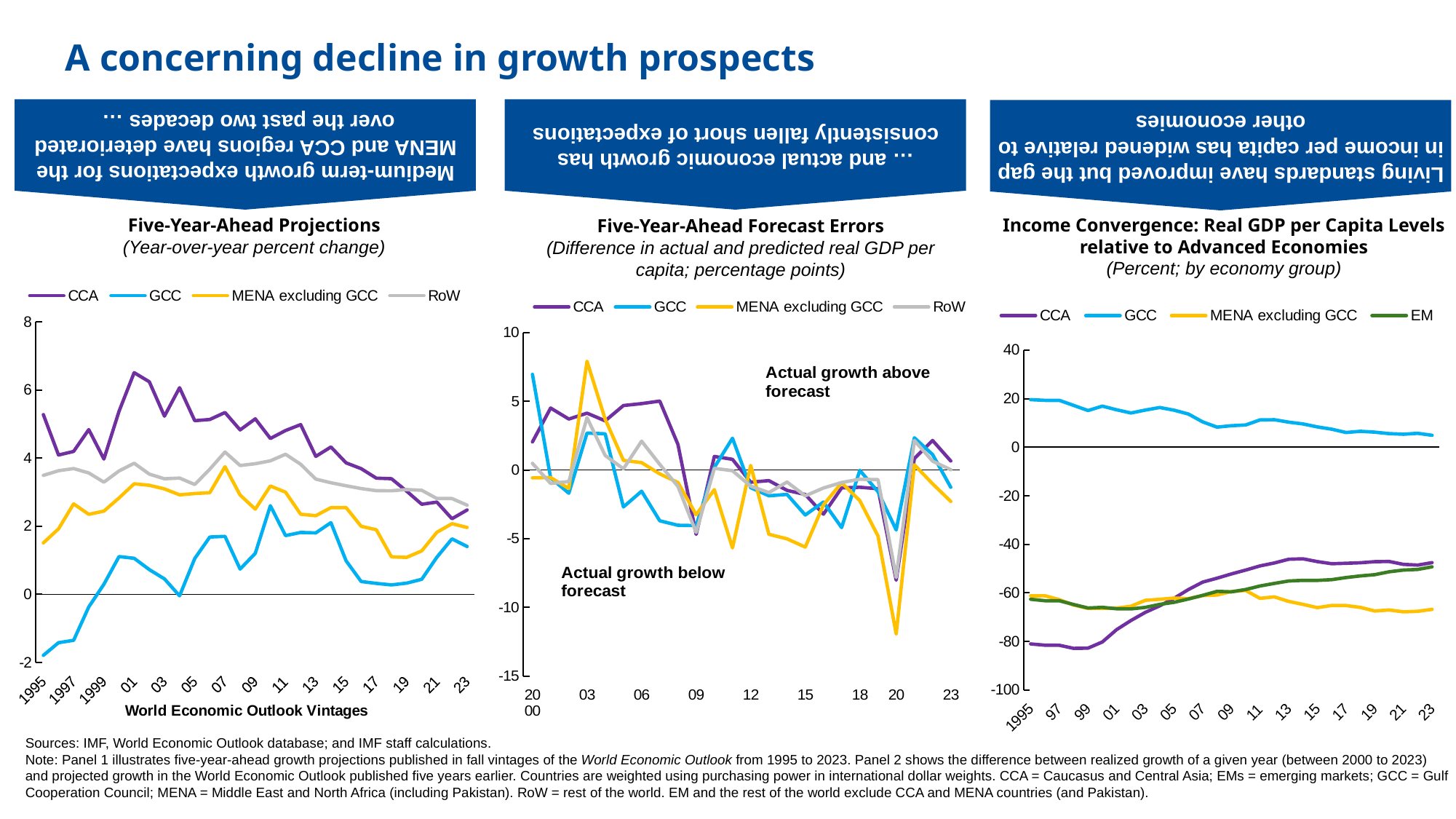
In the 'Five-Year-Ahead Projections' chart, is the value for GCC in 1995 greater or less than 0? less What is the x-axis label of the 'Five-Year-Ahead Projections' chart? World Economic Outlook Vintages In the 'Five-Year-Ahead Projections' chart, is the value for CCA in 2001 greater or less than 6? greater Which series does the legend of the 'Income Convergence' chart list that is not in the other two charts' legends? EM In the 'Five-Year-Ahead Projections' chart, does the CCA line overall rise or fall from 1995 to 2023? fall In the 'Five-Year-Ahead Forecast Errors' chart, is the value for MENA excluding GCC in 2020 greater or less than -10? less How many series does the legend of the 'Five-Year-Ahead Projections' chart list? 4 In the 'Five-Year-Ahead Projections' chart, which series has the highest value in 2001? CCA In the 'Income Convergence' chart, does the CCA line rise or fall from 1995 to 2023? rise In the 'Income Convergence' chart, which series has the highest values across the whole period? GCC What kind of chart is the 'Five-Year-Ahead Projections' chart? line chart